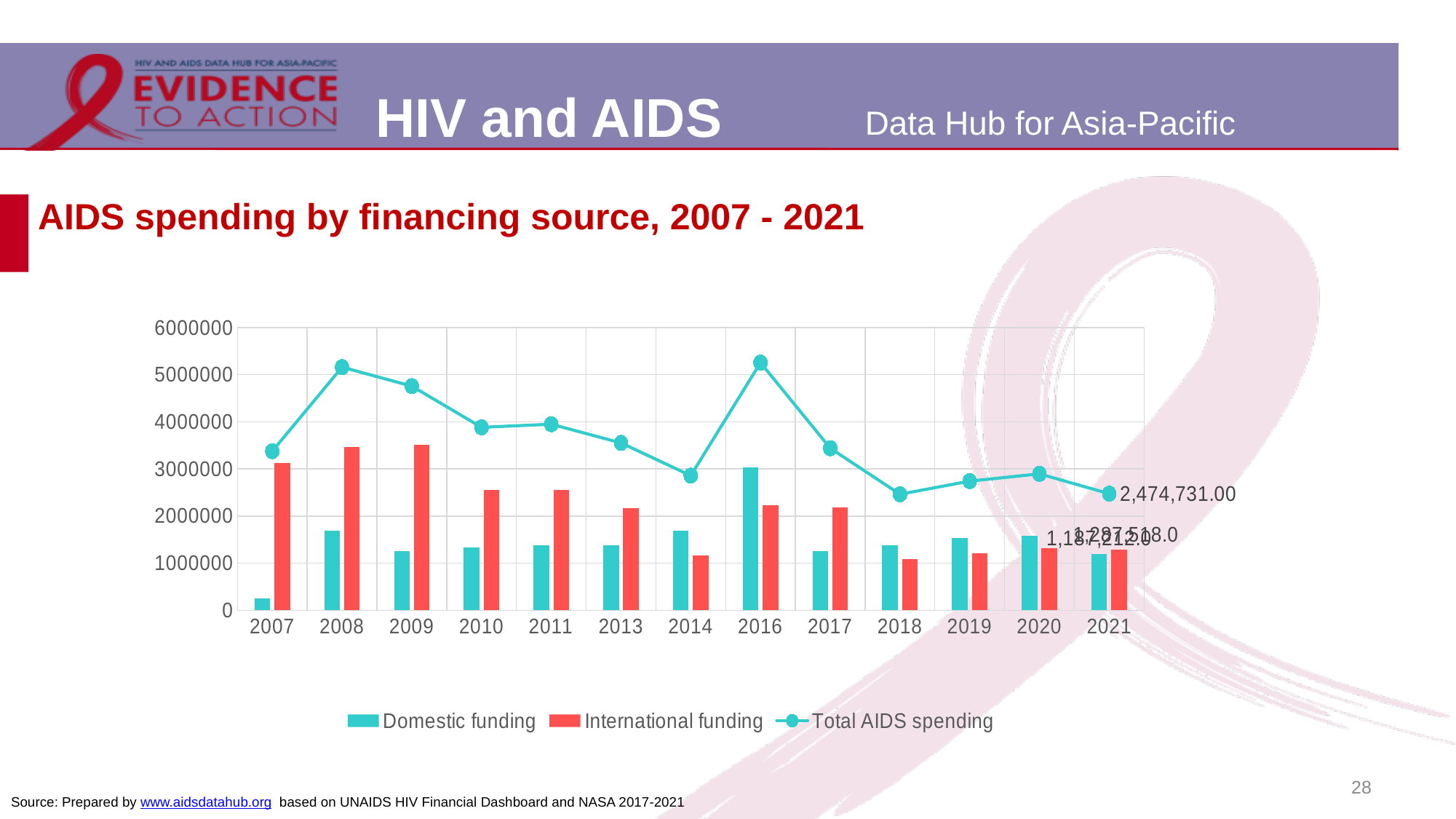
Which year has the highest Domestic funding? 2016 In 2016, which is larger: Domestic funding or International funding? Domestic funding Is the International funding value for 2009 greater or less than 3000000? greater Is the Total AIDS spending value for 2007 greater or less than 3000000? greater Does Total AIDS spending rise or fall from 2016 to 2018? fall How many series does the legend list? 3 What is the Total AIDS spending value labelled for 2021? 2,474,731.00 Which year has the lowest Domestic funding? 2007 How many years are shown on the x axis? 13 Is the Domestic funding value for 2016 greater or less than 2000000? greater What kind of chart is shown on the slide? A bar chart combined with a line In 2007, which is larger: Domestic funding or International funding? International funding